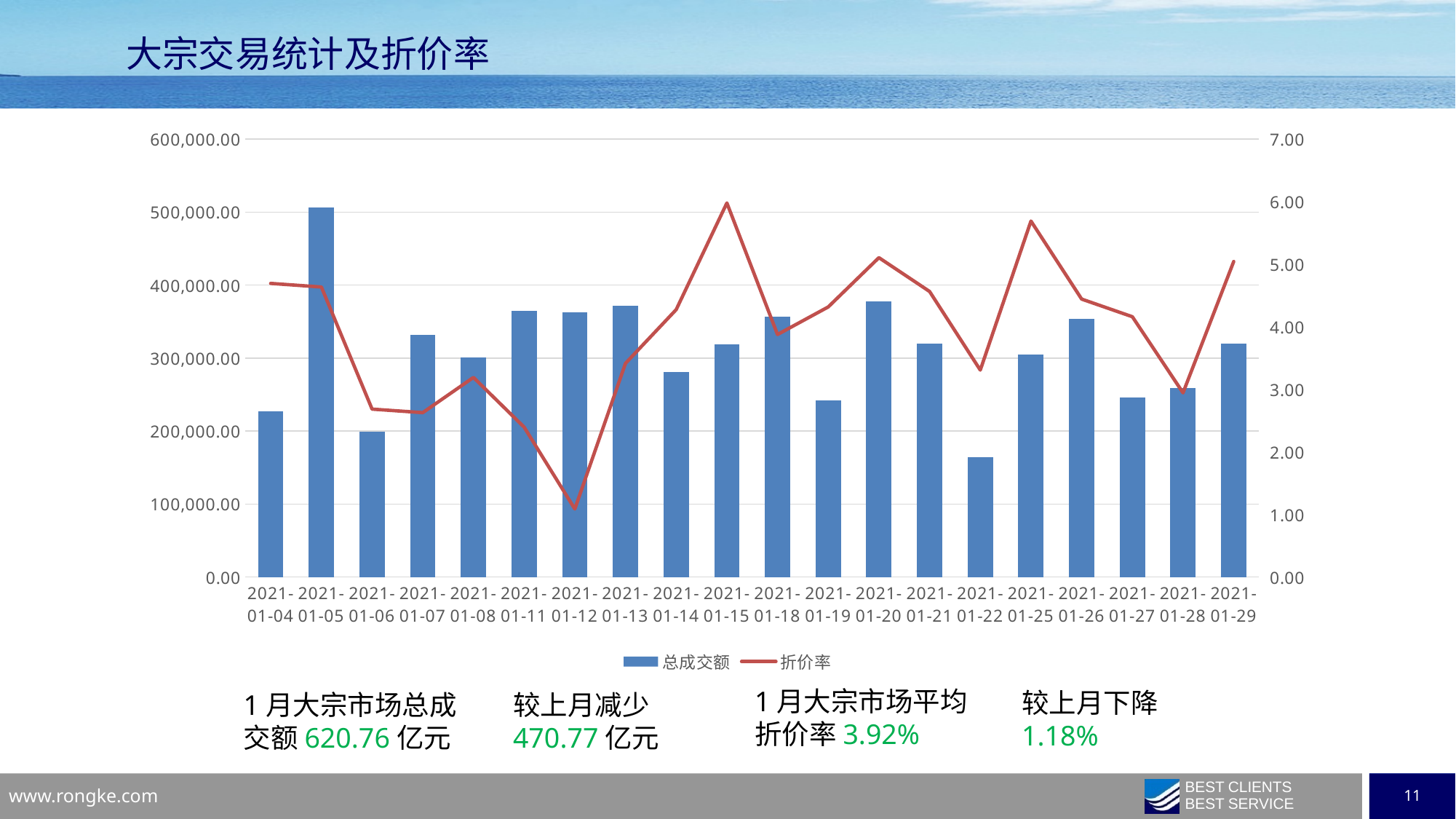
Is the 总成交额 value for 2021-01-05 greater or less than 400,000.00? greater On which date does the 折价率 line reach its highest point? 2021-01-15 How many series does the chart legend list? 2 How many dates are shown on the x axis of the chart? 20 On which date is the 总成交额 bar the lowest? 2021-01-22 Is the 折价率 value for 2021-01-12 greater or less than 2.00? less On which date does the 折价率 line reach its lowest point? 2021-01-12 On which date is the 总成交额 bar the highest? 2021-01-05 Which date has a larger 总成交额 bar, 2021-01-13 or 2021-01-14? 2021-01-13 Does the 折价率 line rise or fall from 2021-01-12 to 2021-01-15? rise What kind of chart is shown on the slide? A combined bar and line chart What is the title of the chart on the slide? 大宗交易统计及折价率